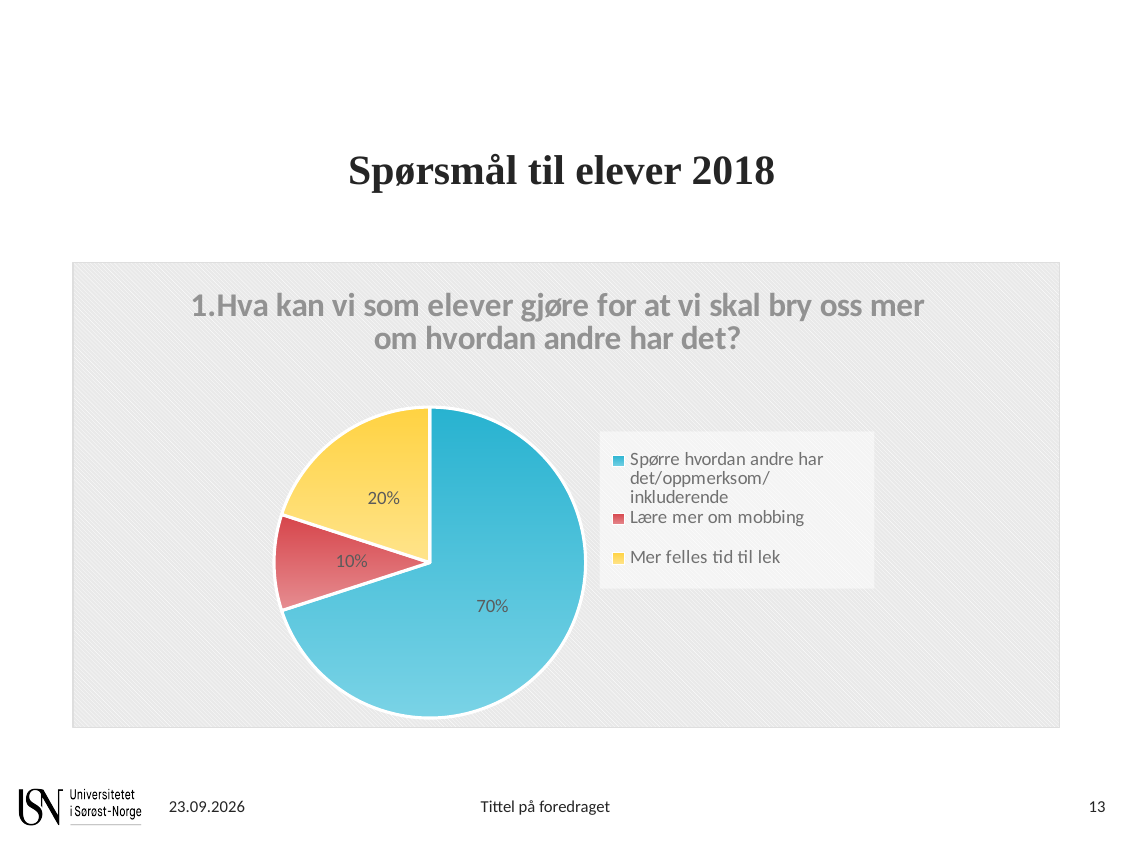
What share of the pie is 'Lære mer om mobbing'? 10% What share of the pie is 'Mer felles tid til lek'? 20% What kind of chart is shown on the slide? pie chart Which category has the largest slice of the pie? Spørre hvordan andre har det/oppmerksom/inkluderende What colour is the slice for 'Lære mer om mobbing'? red How many categories does the pie chart have? 3 Which category has the smallest slice of the pie? Lære mer om mobbing What is the difference in percentage points between 'Mer felles tid til lek' and 'Lære mer om mobbing'? 10 What is the title of the chart? 1.Hva kan vi som elever gjøre for at vi skal bry oss mer om hvordan andre har det? What share of the pie is 'Spørre hvordan andre har det/oppmerksom/inkluderende'? 70% Which is larger: the slice for 'Mer felles tid til lek' or the slice for 'Lære mer om mobbing'? Mer felles tid til lek What is the difference in percentage points between the largest slice and 'Mer felles tid til lek'? 50